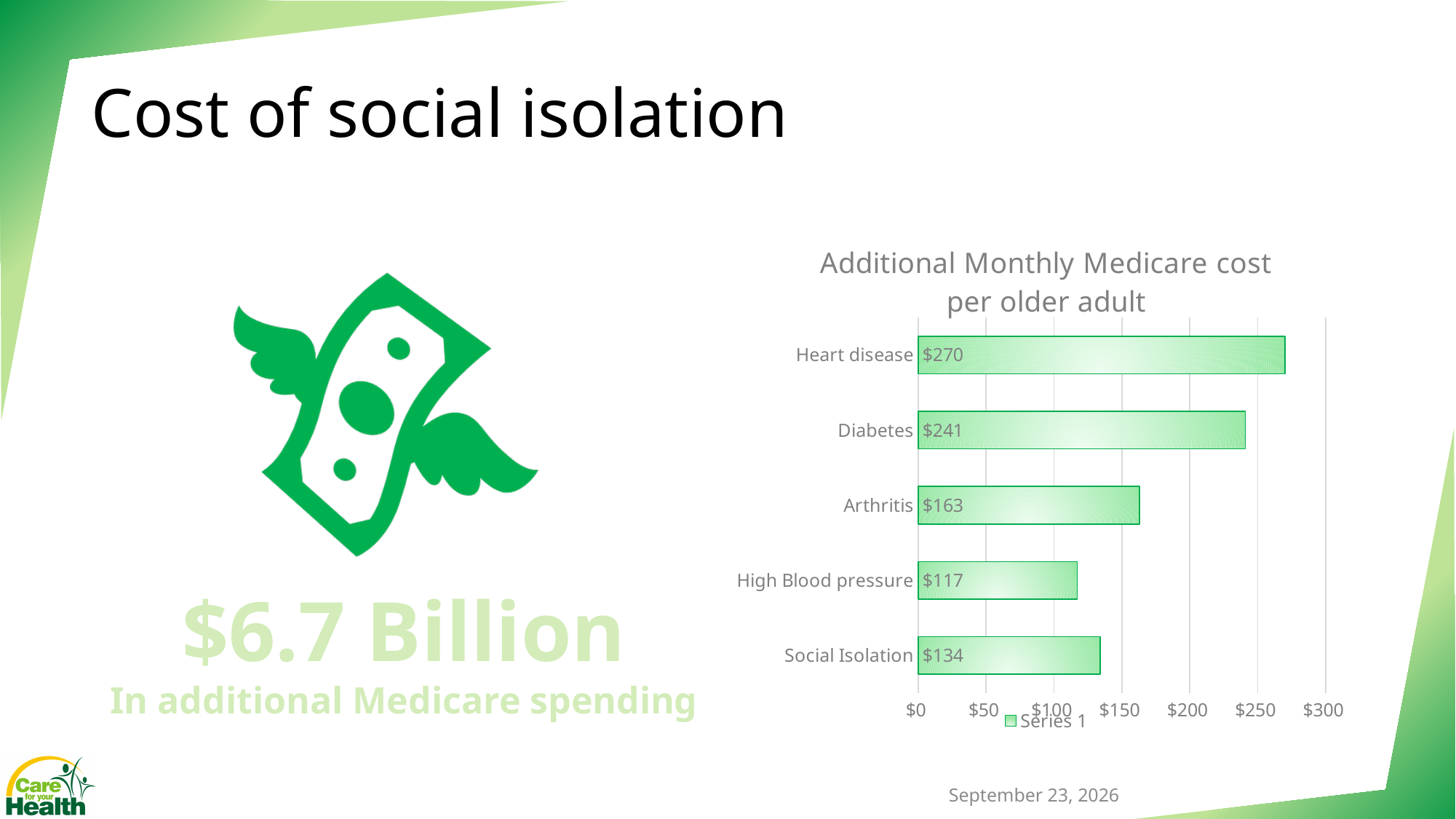
Which is larger, the value for Social Isolation or the value for High Blood pressure? Social Isolation What is the difference between the values for Heart disease and Diabetes? $29 Which category has the highest additional monthly Medicare cost? Heart disease How many categories are shown in the chart? 5 What is the value shown for Arthritis? $163 Which category has the lowest additional monthly Medicare cost? High Blood pressure Is the value for Diabetes greater or less than $200? greater What is the difference between the values for Social Isolation and High Blood pressure? $17 What is the title of the chart? Additional Monthly Medicare cost per older adult What is the additional monthly Medicare cost per older adult for Heart disease? $270 What kind of chart is shown on the slide? bar chart What is the additional monthly Medicare cost per older adult for Social Isolation? $134